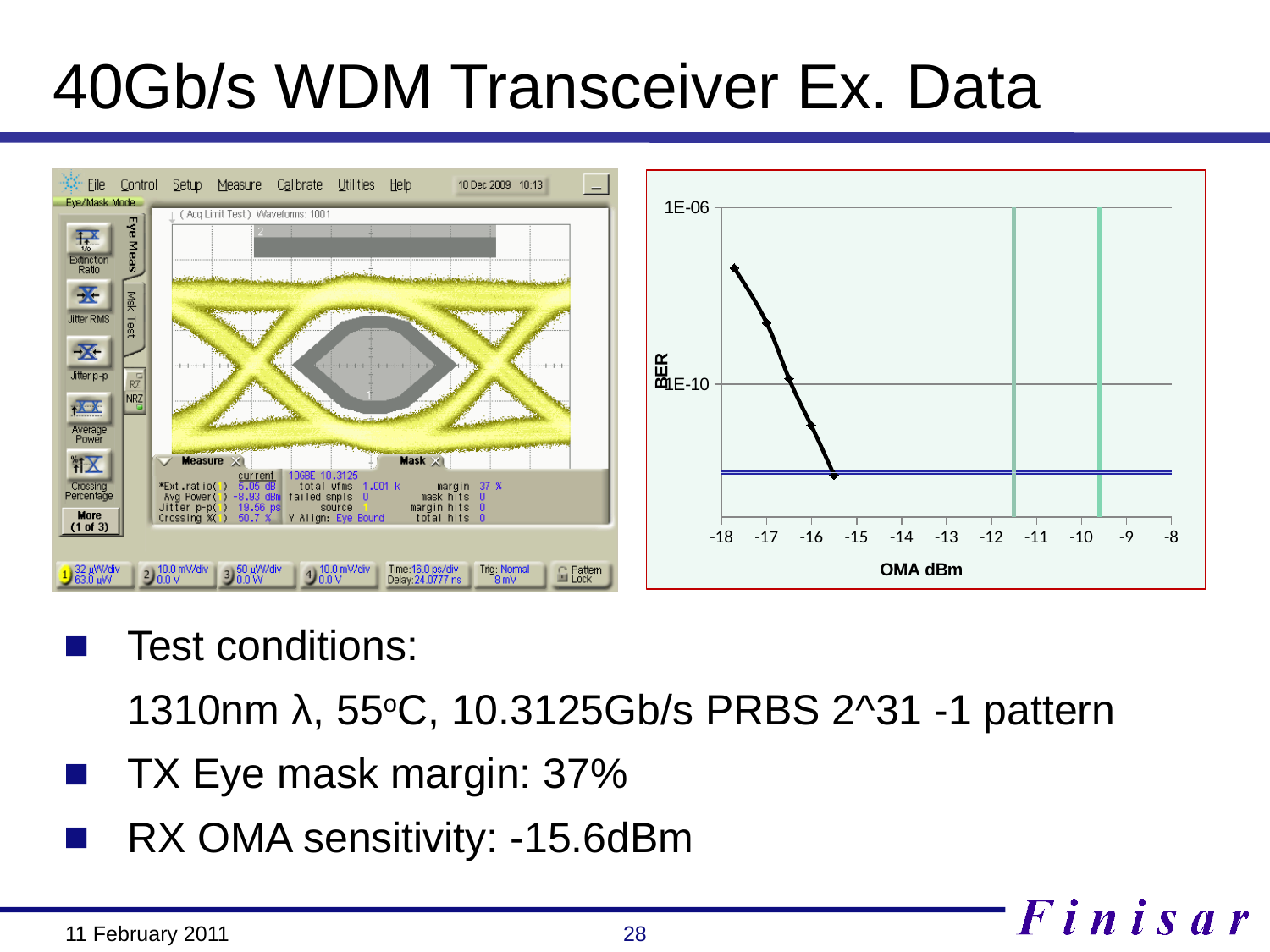
In the BER chart on the right, is the BER of the leftmost data point greater or less than 1E-10? greater In the BER chart on the right, what is the topmost tick value shown on the y axis? 1E-06 In the BER chart on the right, what is the lowest OMA value shown on the x axis? -18 In the BER chart on the right, does the BER rise or fall as OMA increases along the x axis? fall What kind of chart is the BER vs OMA chart on the right of the slide? line chart In the BER chart on the right, which has the higher BER: the leftmost data point or the rightmost data point? the leftmost data point In the BER chart on the right, how many data points are plotted on the black line? 5 In the BER chart on the right, what is the highest OMA value shown on the x axis? -8 In the BER chart on the right, is the BER of the rightmost data point greater or less than 1E-10? less In the BER chart on the right, what is the label of the x axis? OMA dBm In the BER chart on the right, is the BER of the leftmost data point greater or less than 1E-06? less In the BER chart on the right, what is the label of the y axis? BER